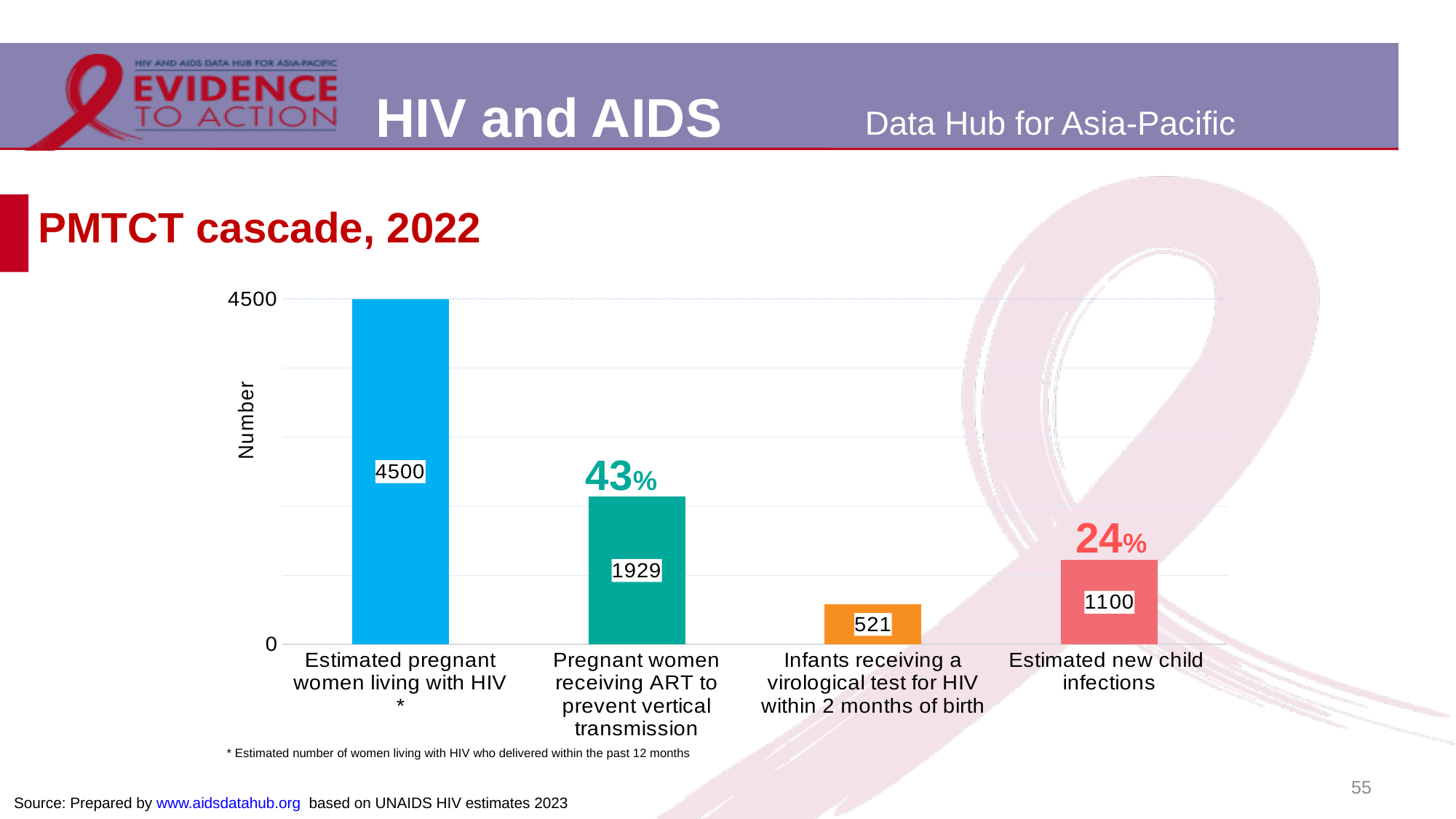
How many categories are shown in the chart? 4 What is the value for Pregnant women receiving ART to prevent vertical transmission? 1929 Which category has the lowest value? Infants receiving a virological test for HIV within 2 months of birth What is the difference between Estimated pregnant women living with HIV and Pregnant women receiving ART to prevent vertical transmission? 2571 What percentage is printed above the Pregnant women receiving ART to prevent vertical transmission bar? 43% What kind of chart is shown on the slide? Bar chart What is the title of the chart? PMTCT cascade, 2022 Which category has the highest value? Estimated pregnant women living with HIV Which is larger: Pregnant women receiving ART to prevent vertical transmission or Estimated new child infections? Pregnant women receiving ART to prevent vertical transmission What is the value for Infants receiving a virological test for HIV within 2 months of birth? 521 What is the value for Estimated pregnant women living with HIV? 4500 What is the value for Estimated new child infections? 1100